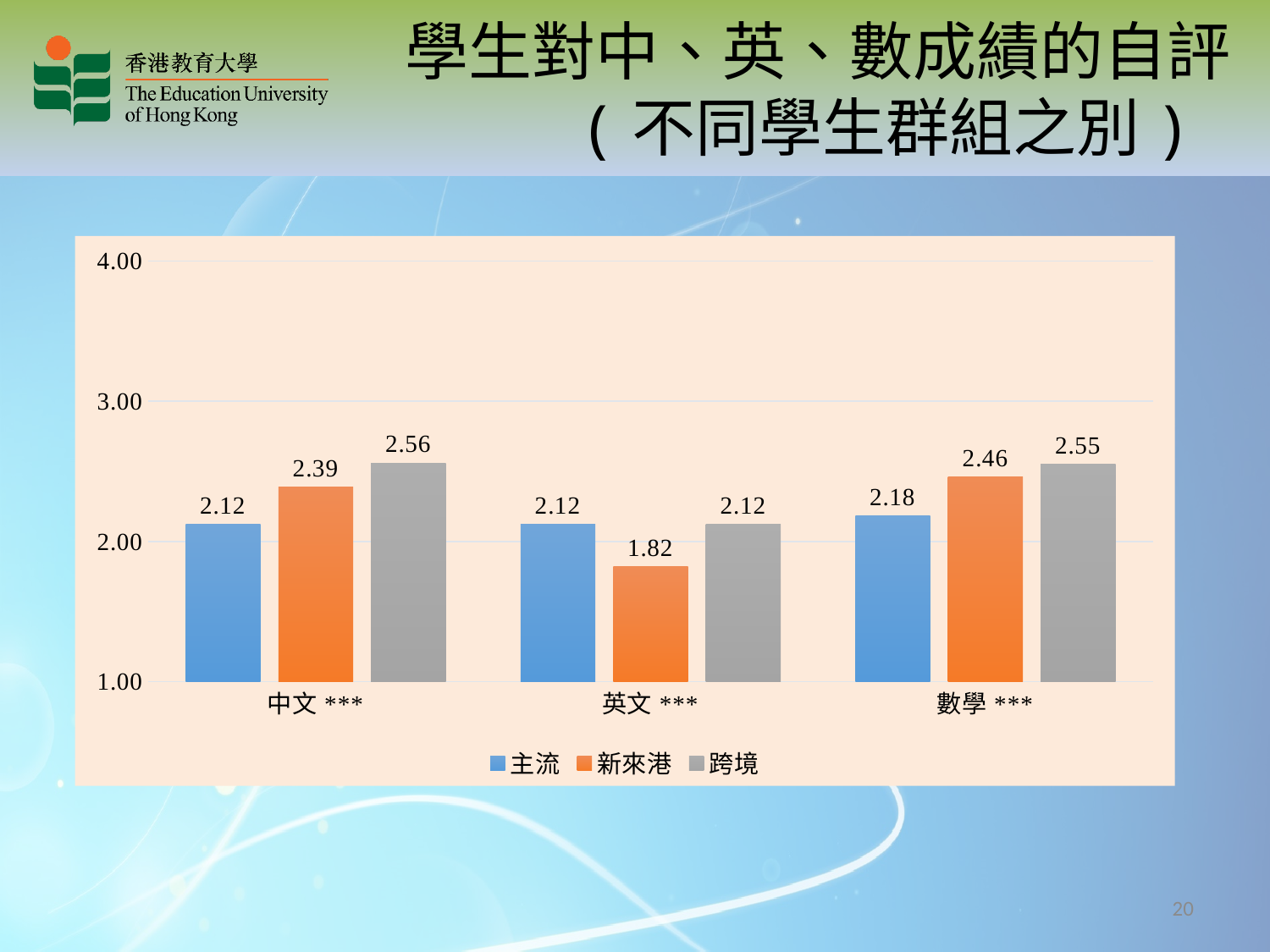
Which is larger: the 新來港 value for 中文 *** or the 新來港 value for 英文 ***? 中文 *** What is the value for 跨境 in the 數學 *** category? 2.55 What is the value for 新來港 in the 中文 *** category? 2.39 How many series does the legend list? 3 What is the difference between the 新來港 and 主流 values in the 數學 *** category? 0.28 What kind of chart is shown on the slide? bar chart Which series has the lowest value in the 英文 *** category? 新來港 What is the difference between the 跨境 and 主流 values in the 中文 *** category? 0.44 Is the value for 新來港 in the 英文 *** category greater or less than 2.00? less How many categories are shown on the x axis? 3 What is the value for 主流 in the 英文 *** category? 2.12 Which series has the highest value in the 中文 *** category? 跨境